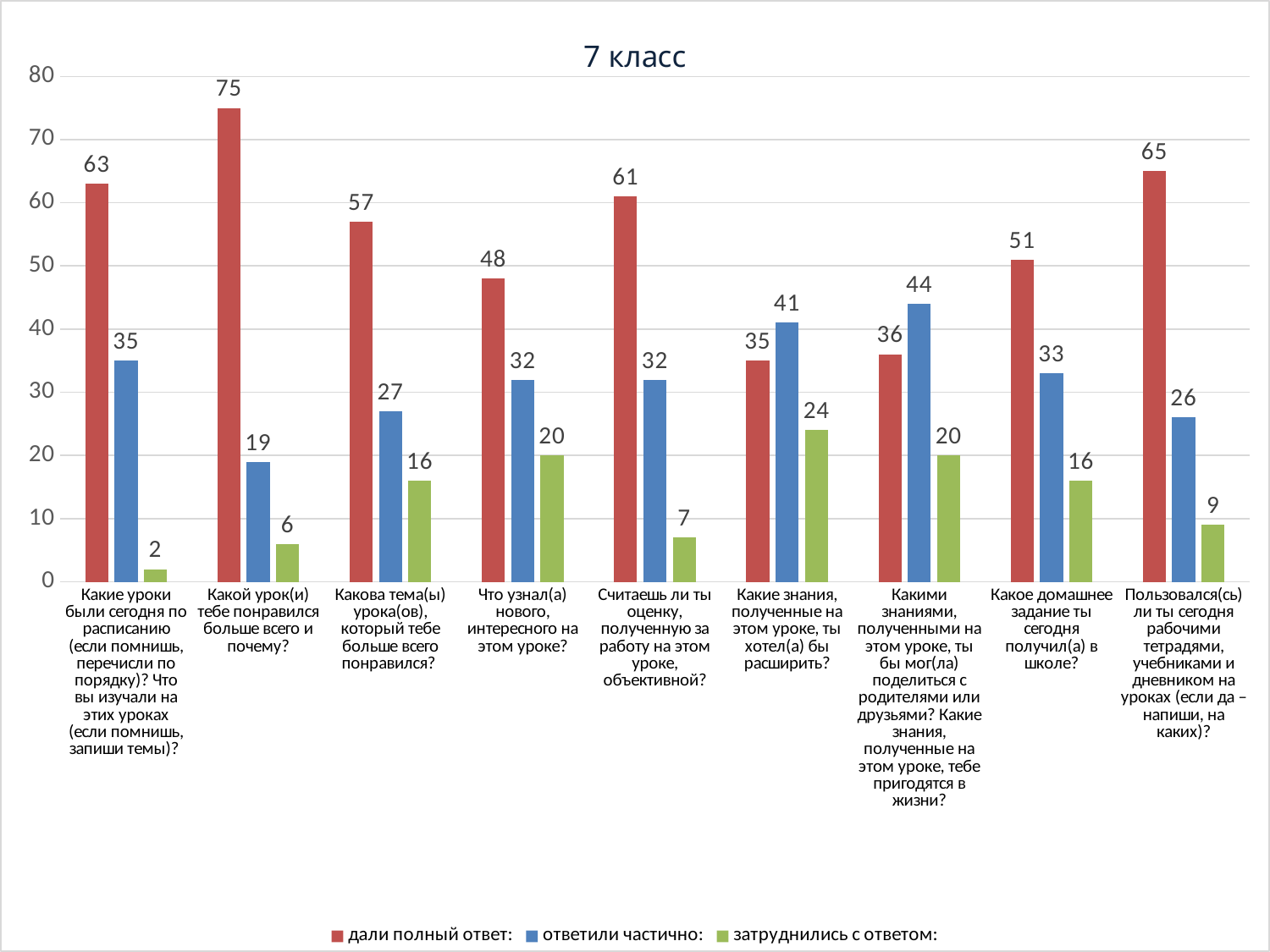
What is the value of "дали полный ответ" for the question "Какой урок(и) тебе понравился больше всего и почему?"? 75 What is the difference between "дали полный ответ" and "ответили частично" for the question "Считаешь ли ты оценку, полученную за работу на этом уроке, объективной?"? 29 Is the "дали полный ответ" value for "Пользовался(сь) ли ты сегодня рабочими тетрадями, учебниками и дневником на уроках?" greater or less than 60? greater For which question is the "затруднились с ответом" value the lowest? Какие уроки были сегодня по расписанию (если помнишь, перечисли по порядку)? Что вы изучали на этих уроках (если помнишь, запиши темы)? What is the value of "затруднились с ответом" for the question "Какие знания, полученные на этом уроке, ты хотел(а) бы расширить?"? 24 What is the value of "ответили частично" for the question "Какое домашнее задание ты сегодня получил(а) в школе?"? 33 For which question is the "дали полный ответ" value the highest? Какой урок(и) тебе понравился больше всего и почему? How many series does the legend list? 3 What is the title of the chart? 7 класс How many question categories are shown along the x axis? 9 For the question "Какими знаниями, полученными на этом уроке, ты бы мог(ла) поделиться с родителями или друзьями?...", which is larger: "дали полный ответ" or "ответили частично"? ответили частично What kind of chart is shown on the slide? bar chart